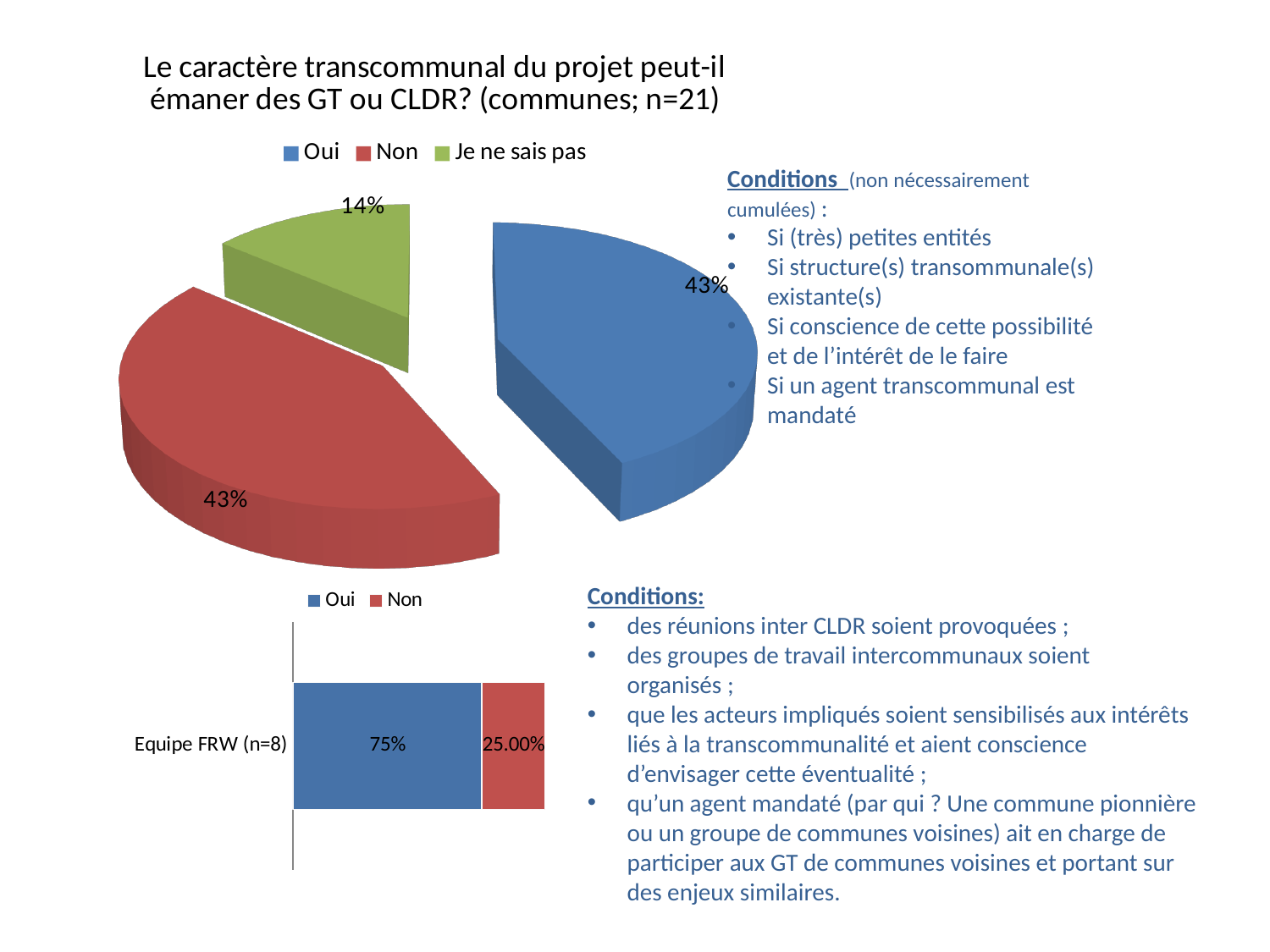
In the pie chart at the top of the slide, which category has the smallest share? Je ne sais pas In the pie chart at the top of the slide, what share of responses is 'Je ne sais pas'? 14% What kind of chart is the top chart on the slide? Pie chart What kind of chart is the bottom chart on the slide? Bar chart In the bottom bar chart, what is the value for 'Oui' for Equipe FRW (n=8)? 75% In the bottom bar chart, which is larger for Equipe FRW (n=8), 'Oui' or 'Non'? Oui In the bottom bar chart, how many series does the legend list? 2 In the pie chart at the top of the slide, how many categories does the legend list? 3 In the bottom bar chart, what is the value for 'Non' for Equipe FRW (n=8)? 25.00% In the pie chart at the top of the slide, what share of responses is 'Oui'? 43% In the pie chart at the top of the slide, what is the difference between the 'Oui' share and the 'Je ne sais pas' share? 29% In the pie chart at the top of the slide, what share of responses is 'Non'? 43%